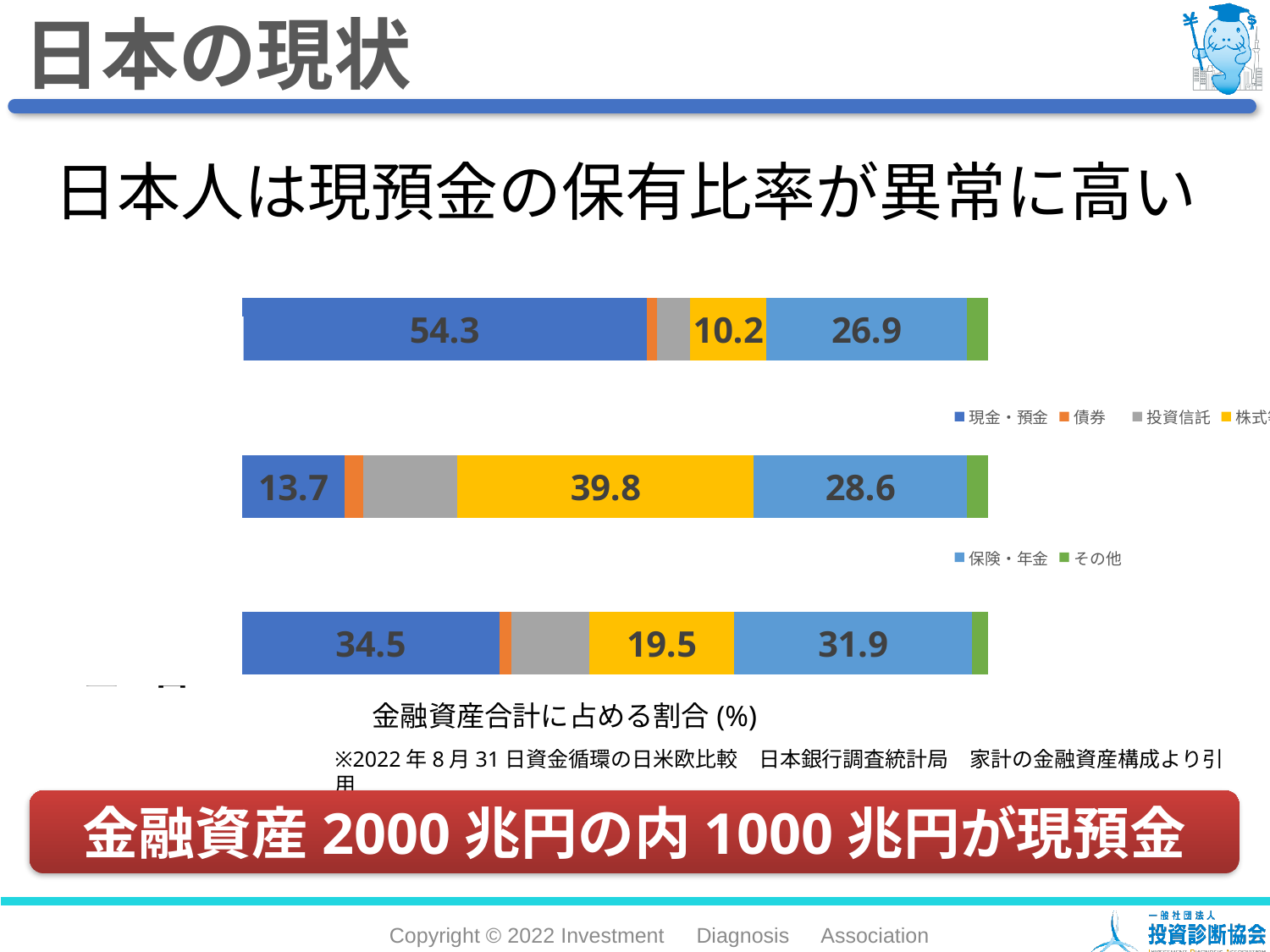
What is the 保険・年金 value shown on the bottom bar? 31.9 How many bars are plotted in the chart? 3 What kind of chart is shown on the slide? Stacked bar chart Which bar has the larger 株式等 value, the middle bar or the bottom bar? Middle bar What is the 保険・年金 value shown on the top bar? 26.9 Which bar (top, middle or bottom) has the lowest 現金・預金 value? Middle bar What colour represents 現金・預金 in the chart? Blue Which bar (top, middle or bottom) has the highest 現金・預金 value? Top bar How many series does the chart's legend list? 6 What is the difference between the 現金・預金 value of the top bar and that of the bottom bar? 19.8 What is the 現金・預金 value shown on the top bar? 54.3 What is the 株式等 value shown on the middle bar? 39.8